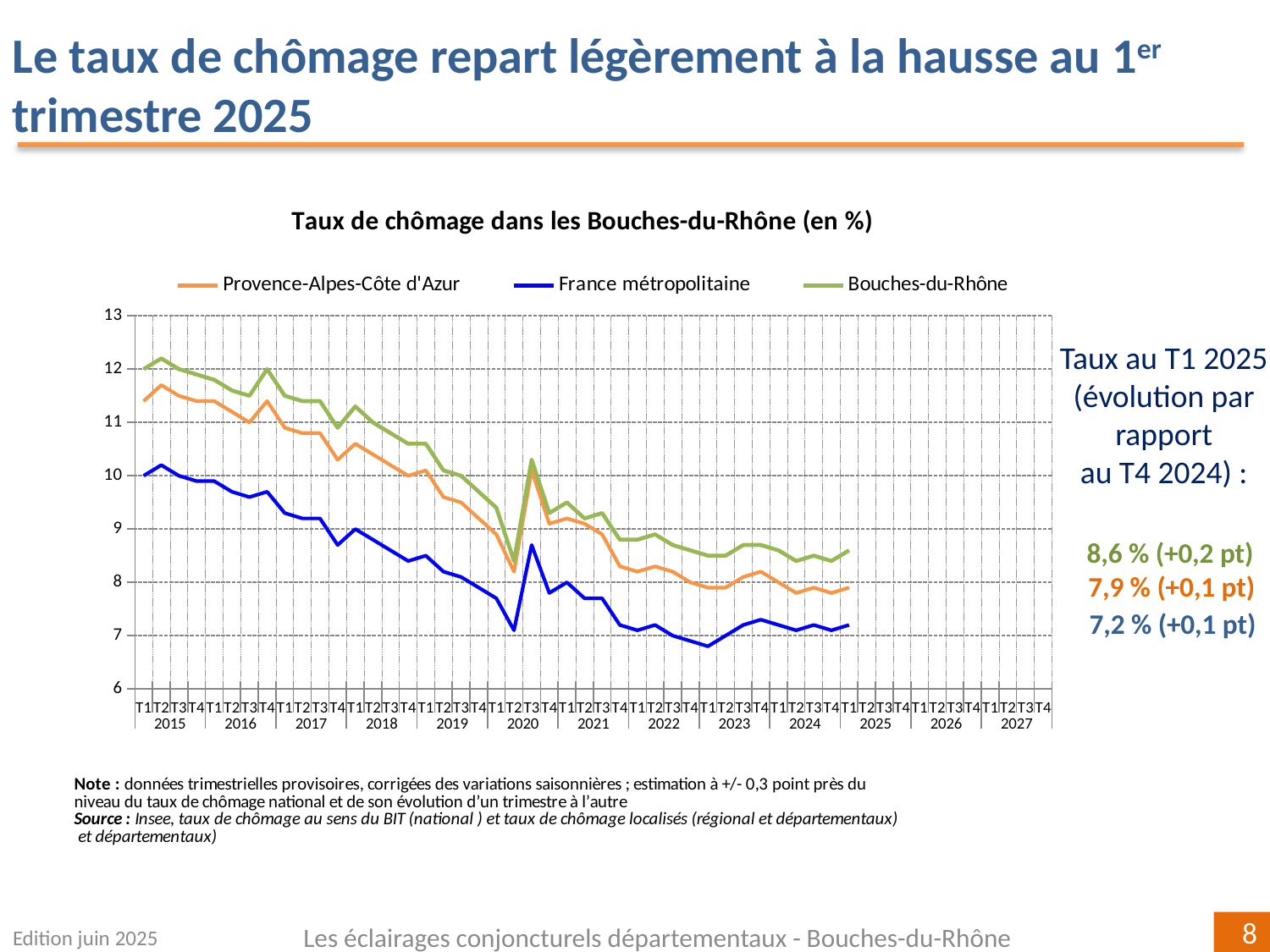
What is the unemployment rate for France métropolitaine at T1 2025? 7,2 % Which series has the highest values across the whole period? Bouches-du-Rhône Overall, do the unemployment rates rise or fall from 2015 to 2025? fall What is the unemployment rate for Provence-Alpes-Côte d'Azur at T1 2025? 7,9 % Is the value for Bouches-du-Rhône at T1 2015 greater or less than 11? greater At T1 2025, which is higher: Provence-Alpes-Côte d'Azur or France métropolitaine? Provence-Alpes-Côte d'Azur What is the unemployment rate for Bouches-du-Rhône at T1 2025? 8,6 % How many series does the legend list? 3 By how much did the Bouches-du-Rhône rate change at T1 2025 compared with T4 2024? +0,2 pt What is the title of the chart? Taux de chômage dans les Bouches-du-Rhône (en %) What is the difference between the Bouches-du-Rhône rate and the France métropolitaine rate at T1 2025? 1,4 points What kind of chart is shown on the slide? line chart